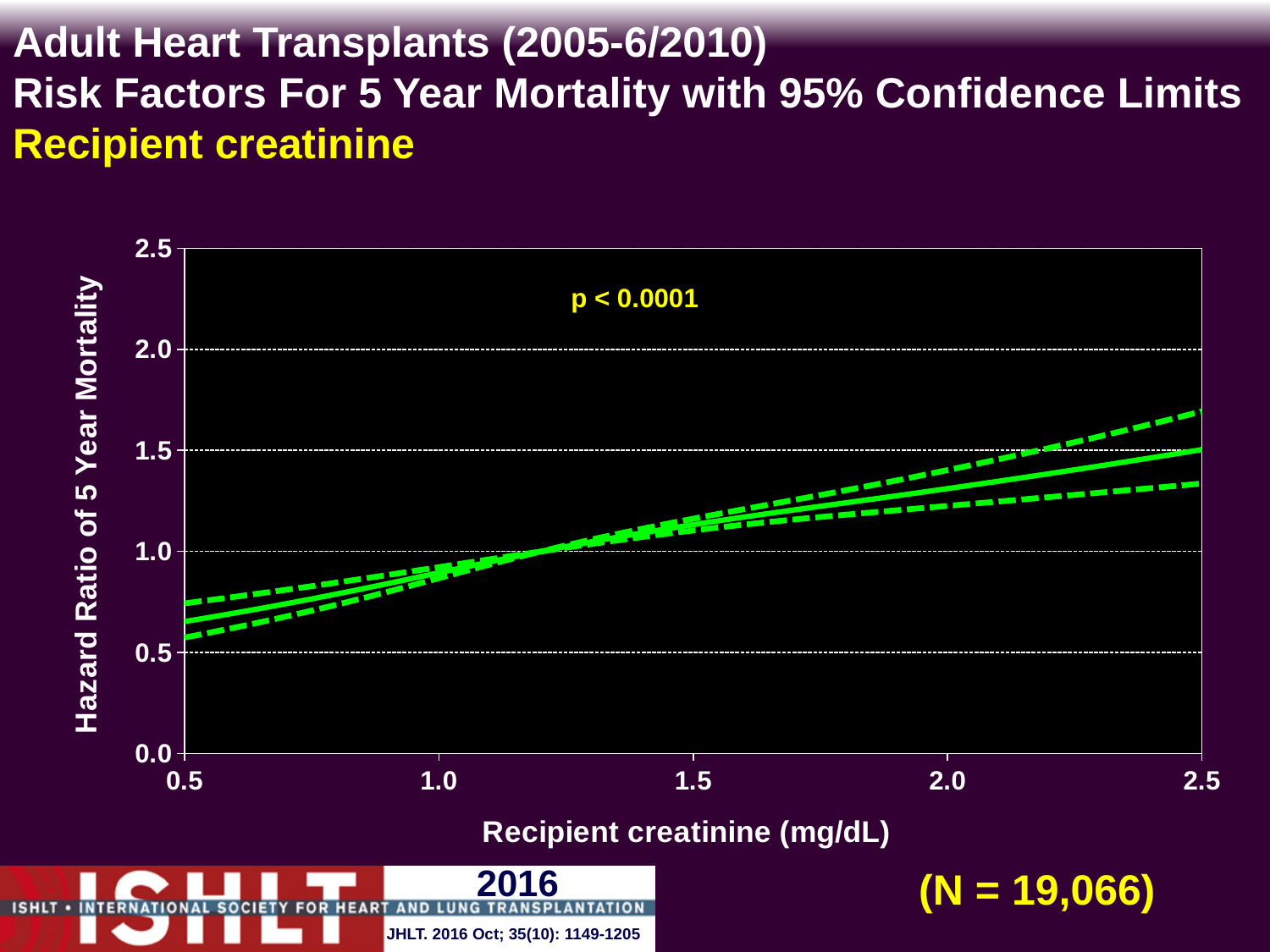
Does the hazard ratio of 5 year mortality rise or fall as recipient creatinine increases from 0.5 to 2.5 mg/dL? rise At which end of the recipient creatinine range, 0.5 or 2.5 mg/dL, is the hazard ratio higher? 2.5 mg/dL Is the hazard ratio (solid line) at a recipient creatinine of 2.0 mg/dL greater or less than 1.0? greater What kind of chart is shown on the slide? line chart What is the sample size (N) shown on the slide? N = 19,066 What p-value is shown on the chart? p < 0.0001 Is the lower 95% confidence limit at a recipient creatinine of 2.5 mg/dL greater or less than 1.5? less Is the upper 95% confidence limit at a recipient creatinine of 2.5 mg/dL greater or less than 1.5? greater How many lines (solid and dashed) are plotted on the chart? 3